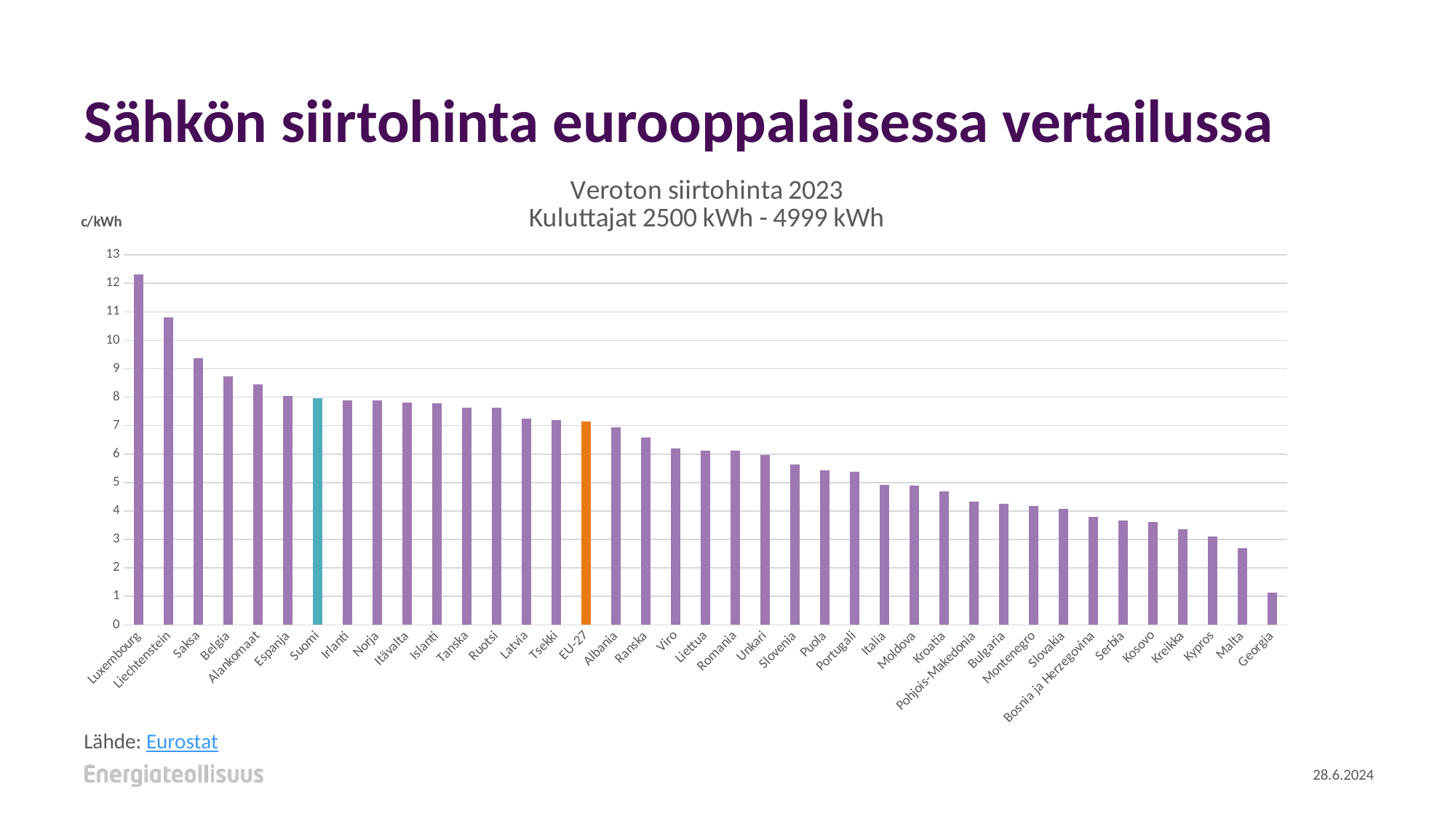
Which country has the highest transmission price in the chart? Luxembourg How many bars (countries/regions) are shown in the chart? 39 What kind of chart is shown on the slide? bar chart Is the value for Saksa greater or less than 9? greater Which is larger, the value for Suomi or the value for EU-27? Suomi Is the value for EU-27 greater or less than 8? less Do the values rise or fall from left to right along the x axis? fall Which country has the lowest transmission price in the chart? Georgia Is the value for Luxembourg greater or less than 12? greater Which is larger, the value for Malta or the value for Georgia? Malta What unit is shown on the y axis of the chart? c/kWh